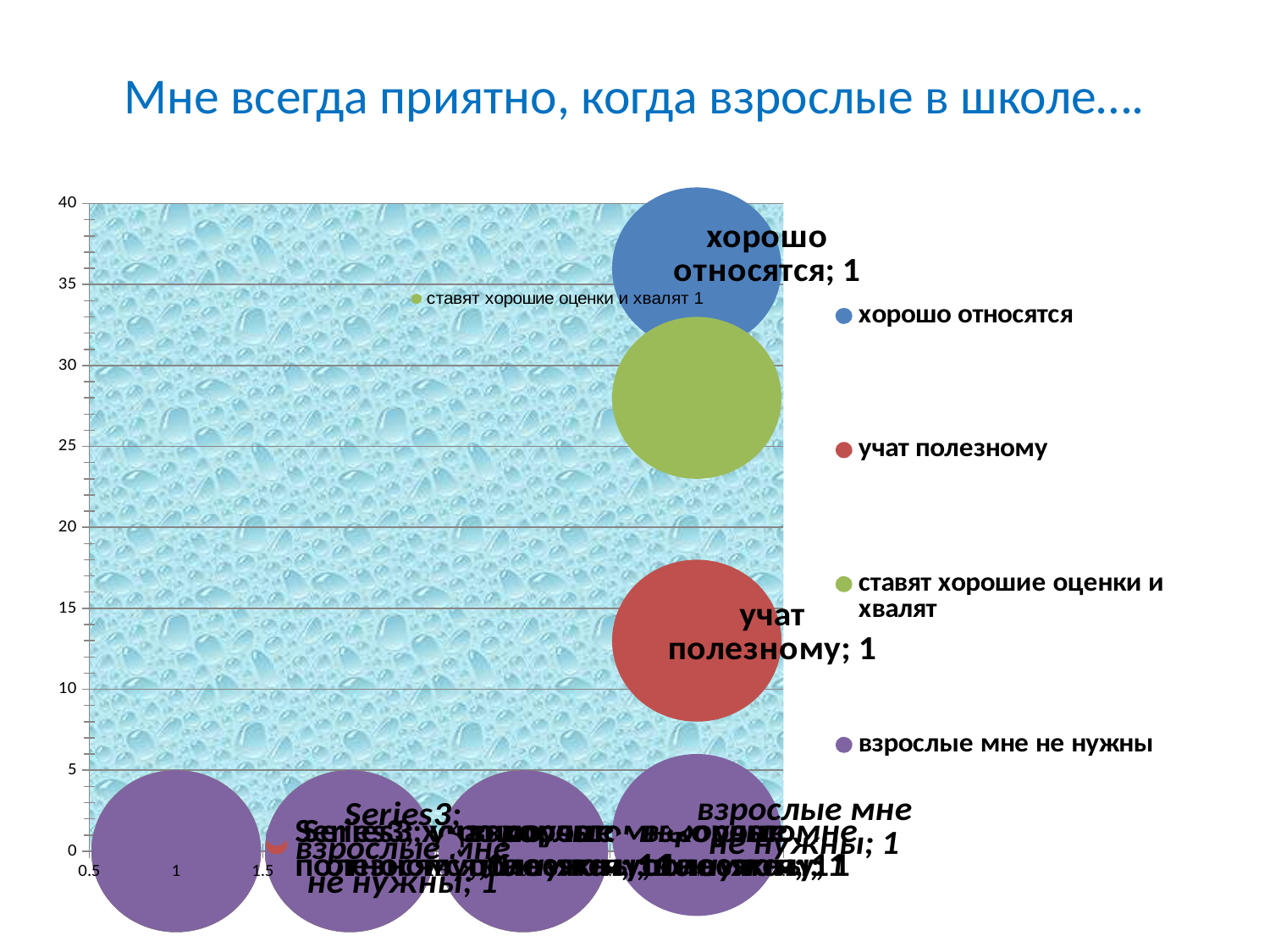
Is the blue 'хорошо относятся' bubble positioned greater or less than 30 on the vertical axis? greater How many series does the legend list? 4 What value is printed in the data label for 'хорошо относятся'? 1 Which series has its bubble positioned highest on the vertical axis? хорошо относятся Is the red 'учат полезному' bubble positioned greater or less than 20 on the vertical axis? less What kind of chart is shown on the slide? bubble chart Is the green 'ставят хорошие оценки и хвалят' bubble positioned greater or less than 20 on the vertical axis? greater Which is positioned higher on the vertical axis, the 'хорошо относятся' bubble or the 'учат полезному' bubble? хорошо относятся What value is printed in the data label for 'учат полезному'? 1 What value is printed in the data label for 'взрослые мне не нужны'? 1 What is the title of the slide? Мне всегда приятно, когда взрослые в школе…. Which colour represents the series 'учат полезному' in the legend? red